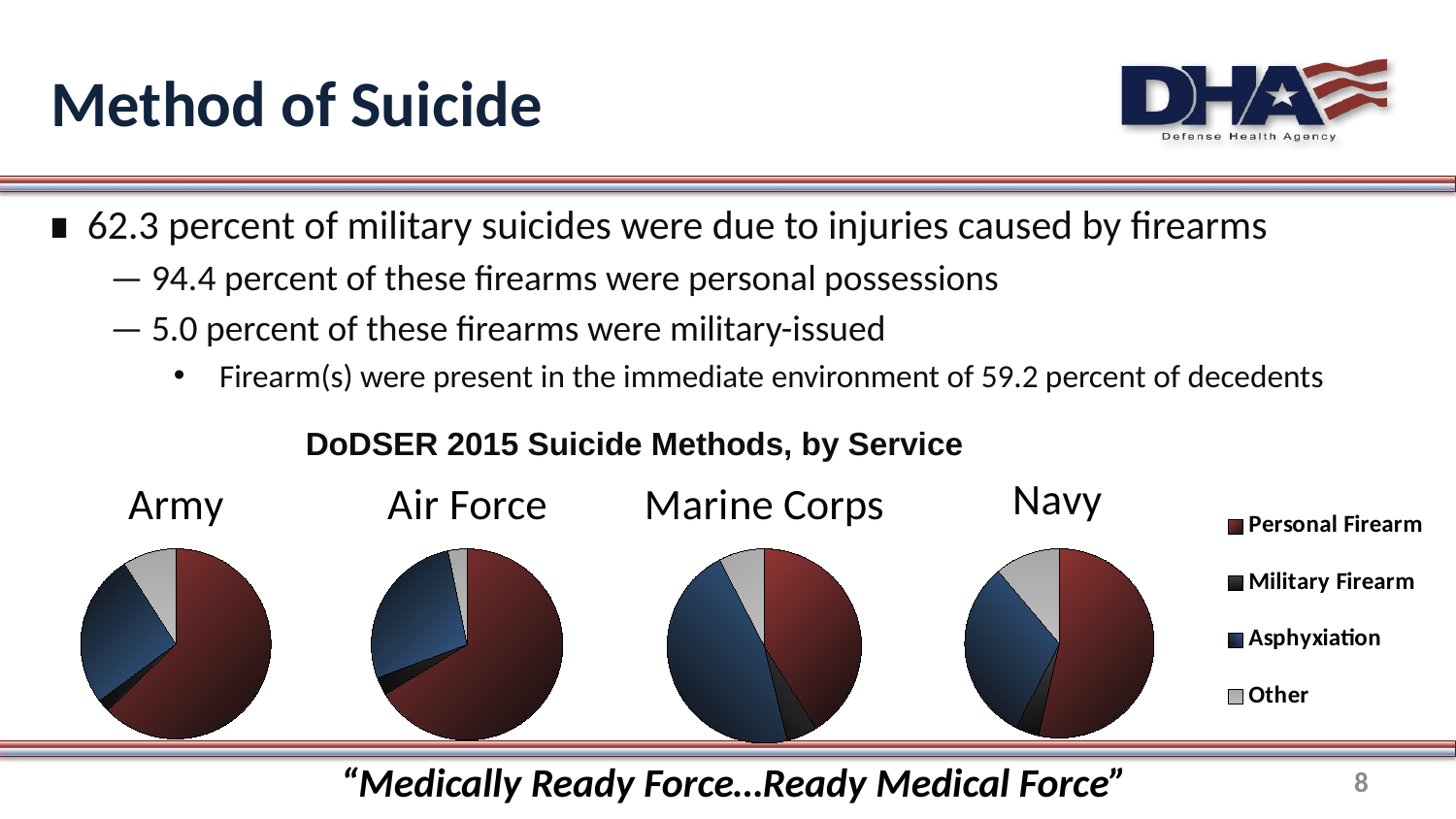
How many categories does the legend for the suicide methods pie charts list? 4 In the Marine Corps pie chart, which slice is larger: Other or Military Firearm? Other In the Air Force pie chart, which method has the largest slice? Personal Firearm In the Marine Corps pie chart, which method has the smallest slice? Military Firearm In the Navy pie chart, which slice is larger: Asphyxiation or Other? Asphyxiation What is the title of the group of pie charts on the slide? DoDSER 2015 Suicide Methods, by Service How many pie charts are shown on the slide? 4 What kind of charts are shown under the title "DoDSER 2015 Suicide Methods, by Service"? Pie charts In the Navy pie chart, which method has the largest slice? Personal Firearm In the Army pie chart, which method has the smallest slice? Military Firearm In the Army pie chart, which method has the largest slice? Personal Firearm Which service's pie chart is shown furthest to the right? Navy